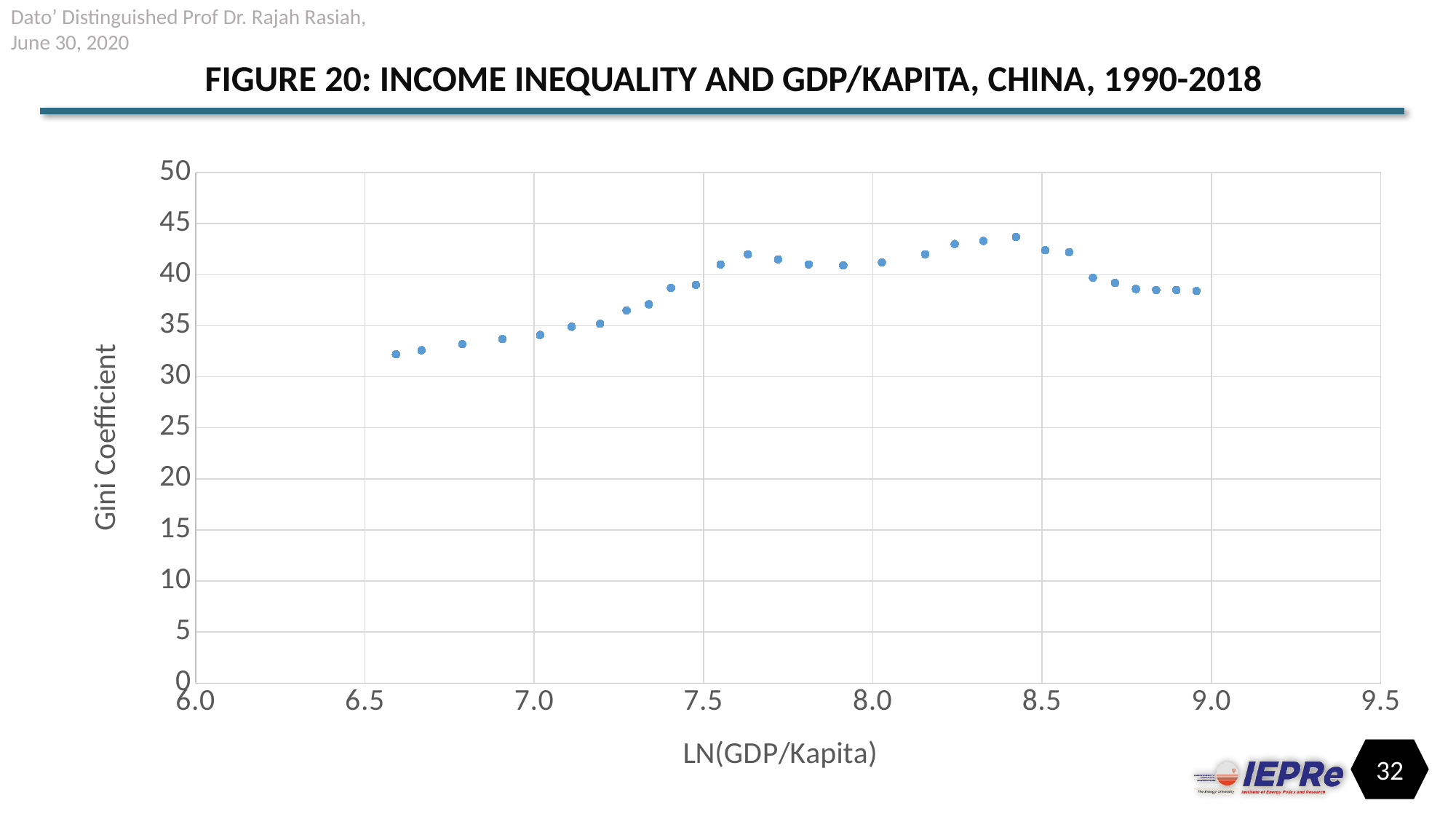
What is the title of the chart? FIGURE 20: INCOME INEQUALITY AND GDP/KAPITA, CHINA, 1990-2018 Around which LN(GDP/Kapita) value does the Gini Coefficient reach its highest point: about 7.0, about 8.4, or about 9.0? about 8.4 What kind of chart is shown on the slide? scatter chart Is the Gini Coefficient for the rightmost point (around LN(GDP/Kapita) 9.0) greater or less than 40? less Which has the lower Gini Coefficient: the point at LN(GDP/Kapita) of about 7.0 or the point at about 9.0? the point at about 7.0 Does the Gini Coefficient rise or fall as LN(GDP/Kapita) increases from 6.6 to 7.6? rise Is the Gini Coefficient for the leftmost point (around LN(GDP/Kapita) 6.6) greater or less than 35? less Does the Gini Coefficient rise or fall as LN(GDP/Kapita) increases from 8.4 to 9.0? fall Is the Gini Coefficient for the highest point (around LN(GDP/Kapita) 8.4) greater or less than 40? greater What is the label of the vertical axis? Gini Coefficient Which has the higher Gini Coefficient: the point at LN(GDP/Kapita) of about 6.6 or the point at about 8.4? the point at about 8.4